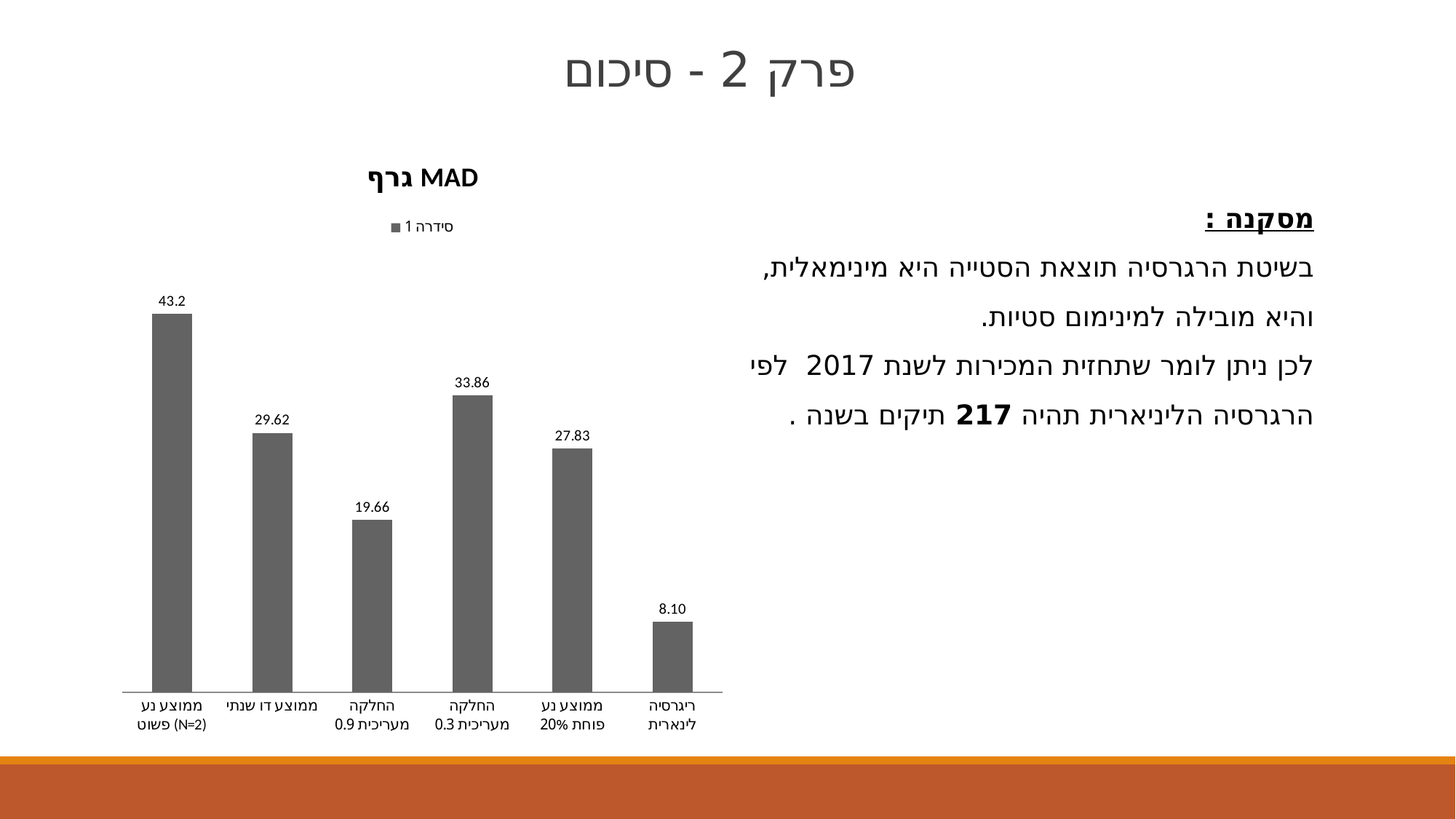
Which category has the lowest value? ריגרסיה לינארית What is the value for ממוצע דו שנתי? 29.62 How many series does the chart legend list? 1 What is the title of the chart? גרף MAD Which category has the highest value? ממוצע נע פשוט (N=2) What is the difference between the values for החלקה מעריכית 0.3 and החלקה מעריכית 0.9? 14.20 What is the value for ממוצע נע פוחת 20%? 27.83 What type of chart is shown on the slide? bar chart How many categories are plotted in the chart? 6 What is the value for החלקה מעריכית 0.3? 33.86 What is the value for רגרסיה לינארית? 8.10 Which is larger, the value for ממוצע דו שנתי or the value for ממוצע נע פוחת 20%? ממוצע דו שנתי